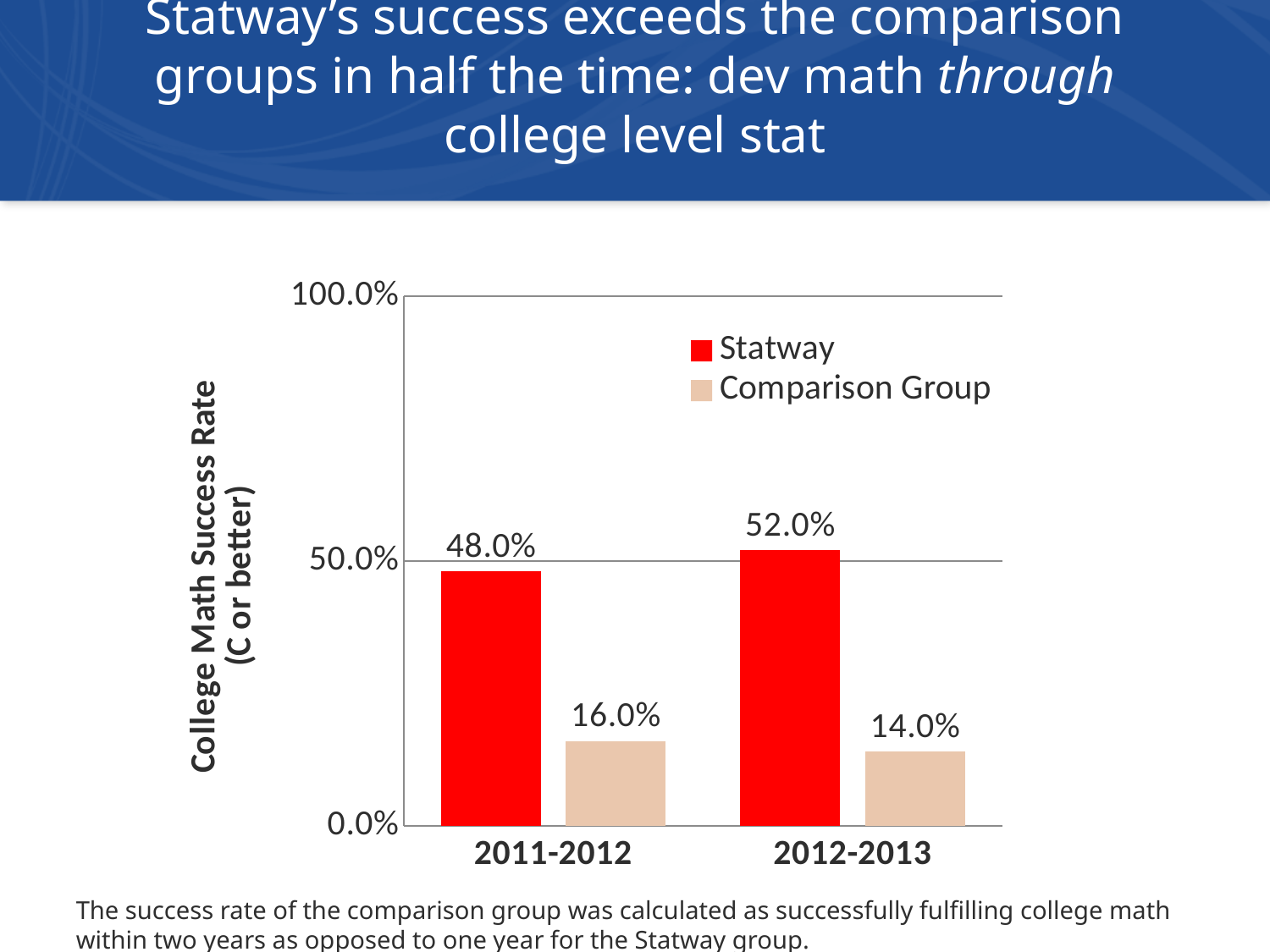
What is the difference between the Statway and Comparison Group success rates in 2011-2012? 32.0% What is the Comparison Group success rate for 2011-2012? 16.0% Which year has the higher Statway success rate? 2012-2013 Which bar shows the lowest value on the chart? Comparison Group, 2012-2013 By how much did the Statway success rate change from 2011-2012 to 2012-2013? 4.0% Which is larger: the Comparison Group rate in 2011-2012 or in 2012-2013? 2011-2012 Is the Statway value for 2012-2013 greater or less than 50.0%? greater What is the y-axis label of the chart? College Math Success Rate (C or better) What is the Comparison Group success rate for 2012-2013? 14.0% What is the Statway success rate for 2011-2012? 48.0% What kind of chart is shown on the slide? Bar chart How many series does the legend list? 2